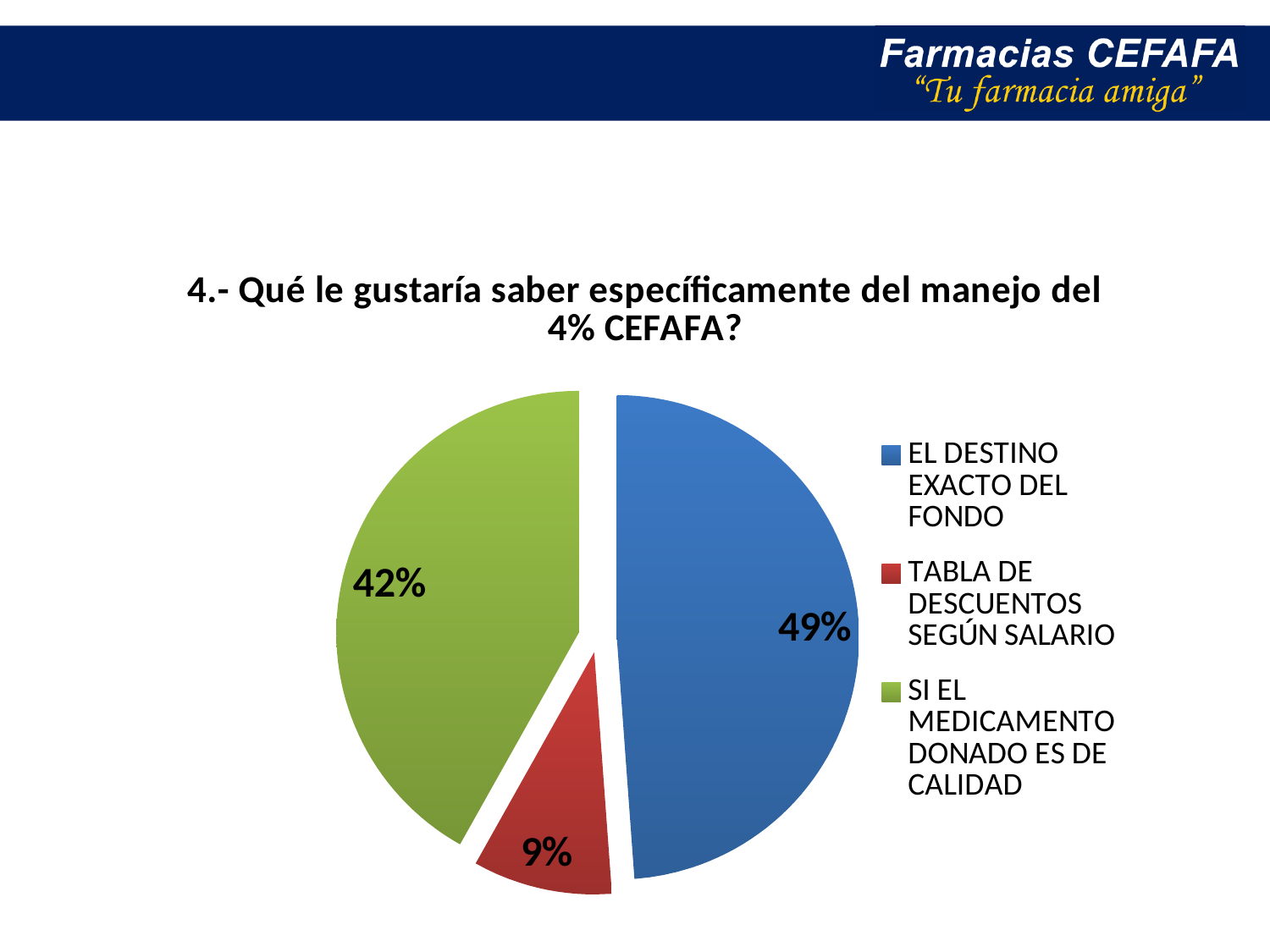
What is the title of the chart? 4.- Qué le gustaría saber específicamente del manejo del 4% CEFAFA? Which colour represents TABLA DE DESCUENTOS SEGÚN SALARIO in the pie chart? Red What share of the pie does TABLA DE DESCUENTOS SEGÚN SALARIO represent? 9% What kind of chart is shown on the slide? Pie chart Which category has the largest slice of the pie? EL DESTINO EXACTO DEL FONDO How many categories does the pie chart show? 3 What is the difference in percentage points between EL DESTINO EXACTO DEL FONDO and SI EL MEDICAMENTO DONADO ES DE CALIDAD? 7% What share of the pie does SI EL MEDICAMENTO DONADO ES DE CALIDAD represent? 42% What is the difference in percentage points between SI EL MEDICAMENTO DONADO ES DE CALIDAD and TABLA DE DESCUENTOS SEGÚN SALARIO? 33% Which is larger: the slice for EL DESTINO EXACTO DEL FONDO or the slice for SI EL MEDICAMENTO DONADO ES DE CALIDAD? EL DESTINO EXACTO DEL FONDO Which category has the smallest slice of the pie? TABLA DE DESCUENTOS SEGÚN SALARIO What share of the pie does EL DESTINO EXACTO DEL FONDO represent? 49%